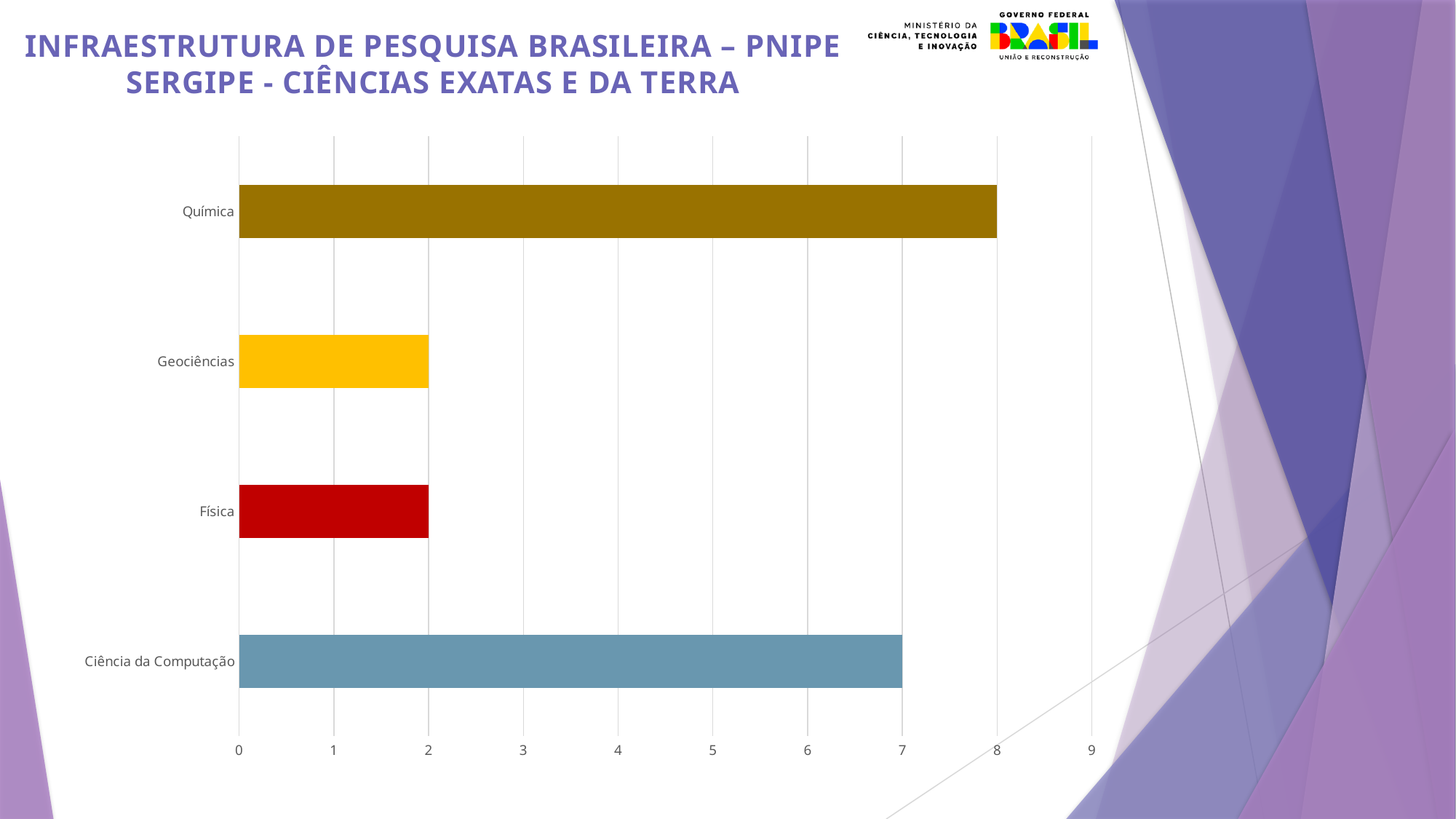
What is the difference between the values for Química and Ciência da Computação? 1 What is the value for Química? 8 Is the value for Ciência da Computação greater or less than 5? greater How many categories are shown in the chart? 4 Which is larger, the value for Ciência da Computação or the value for Física? Ciência da Computação What is the value for Geociências? 2 What kind of chart is shown on the slide? Bar chart What is the difference between the values for Química and Geociências? 6 Which category has the highest value? Química What colour is the bar for Física? Red What is the value for Ciência da Computação? 7 What is the value for Física? 2